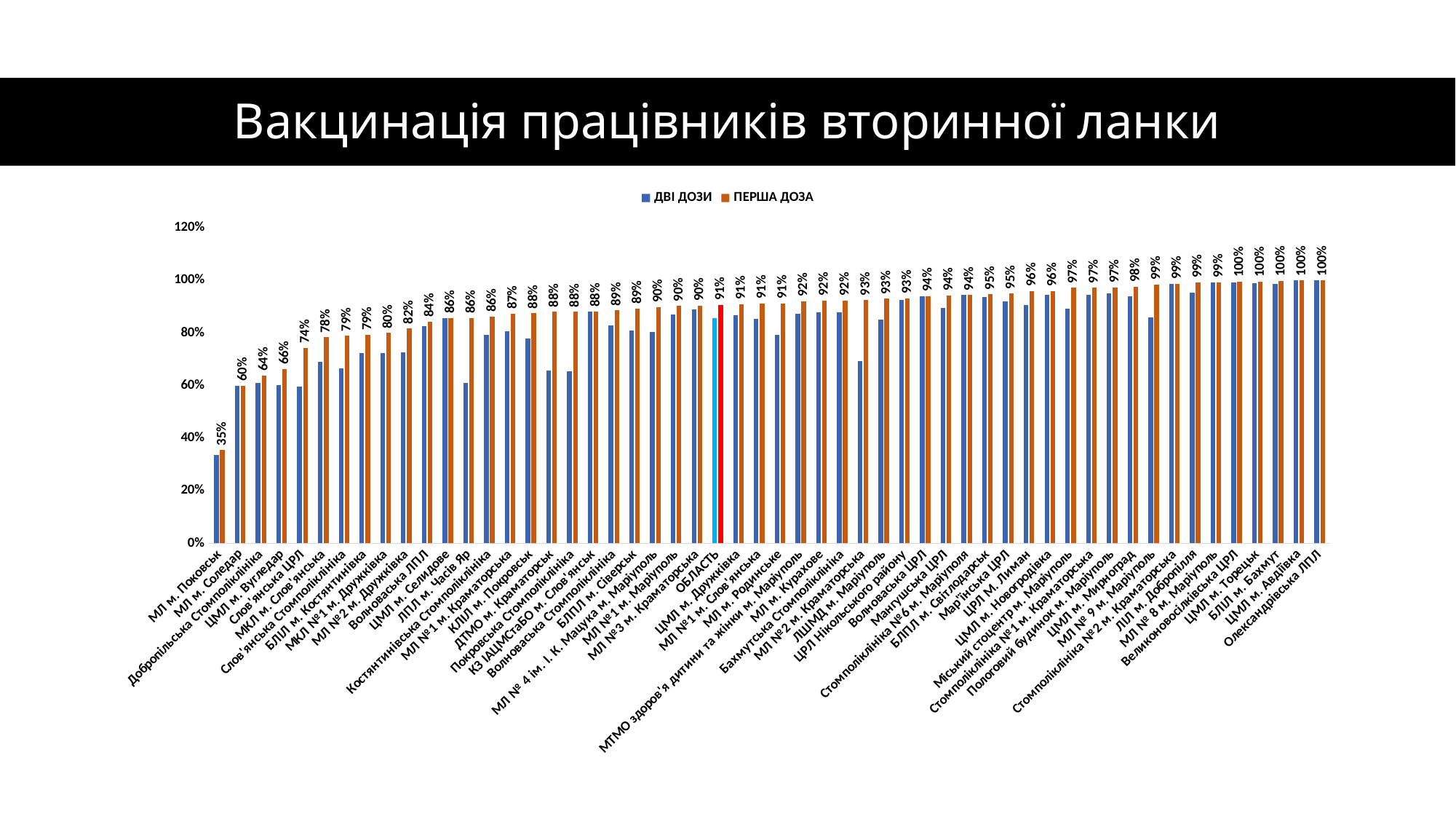
Which category has the lowest first-dose (ПЕРША ДОЗА) value? МЛ м. Покровськ Is the two-dose (ДВІ ДОЗИ) value for Олександрівська ЛПЛ greater or less than 80%? greater What is the first-dose (ПЕРША ДОЗА) value for МЛ м. Покровськ? 35% How many series does the legend list? 2 Do the first-dose (ПЕРША ДОЗА) values rise or fall from left to right along the x axis? Rise What is the first-dose (ПЕРША ДОЗА) value for ЦМЛ м. Мирноград? 98% What is the first-dose (ПЕРША ДОЗА) value for ОБЛАСТЬ? 91% Which category's two-dose bar is coloured red instead of blue? ОБЛАСТЬ What kind of chart is shown on the slide? Bar chart Which has a higher first-dose value: МЛ м. Соледар or Слов'янська ЦРЛ? Слов'янська ЦРЛ What is the difference between the first-dose values for Олександрівська ЛПЛ and МЛ м. Покровськ? 65% Is the two-dose (ДВІ ДОЗИ) value for ЛПЛ м. Часів Яр greater or less than 80%? less